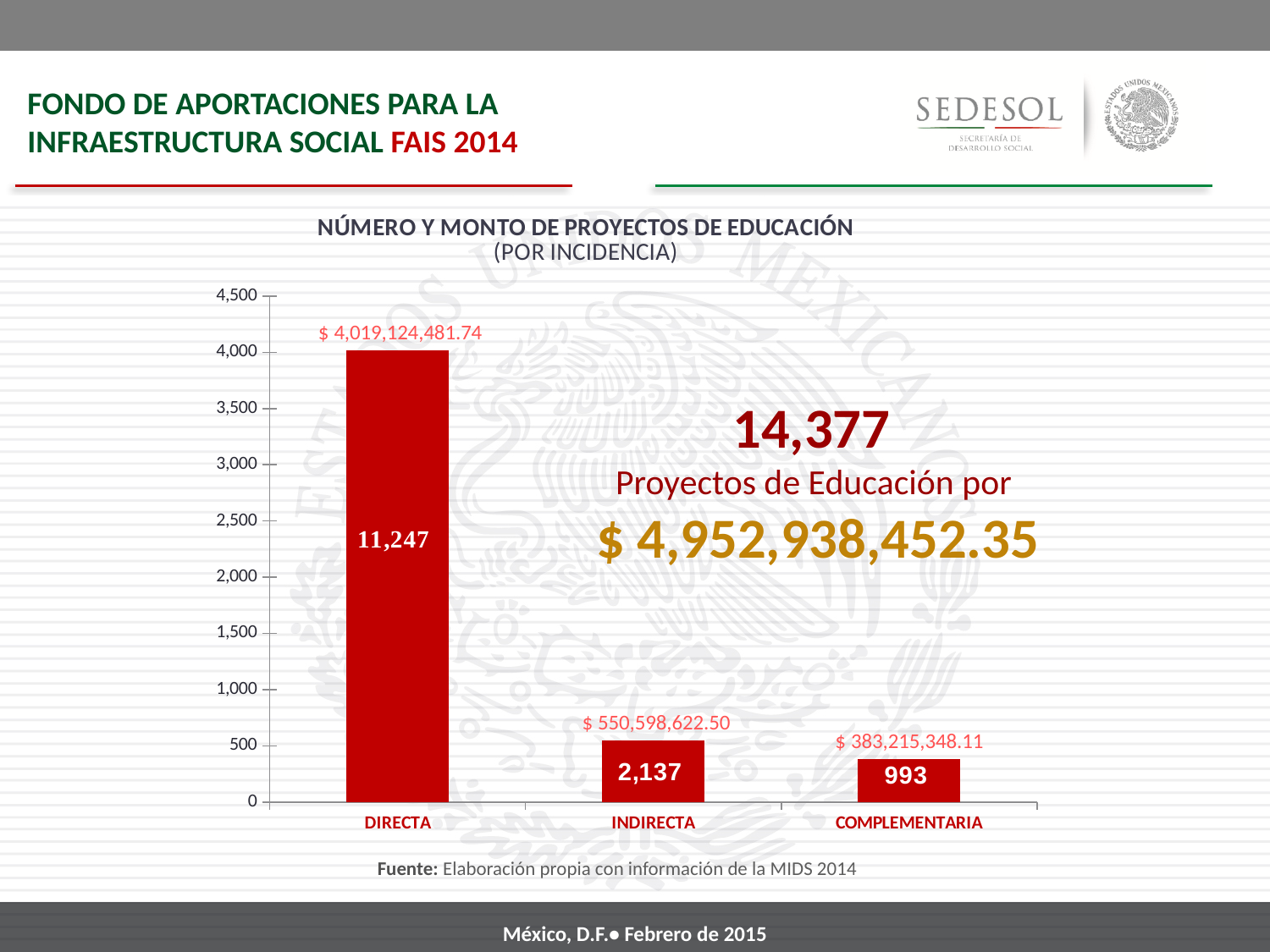
What is the title of the chart? NÚMERO Y MONTO DE PROYECTOS DE EDUCACIÓN (POR INCIDENCIA) Which category has the shortest bar? COMPLEMENTARIA What amount is printed above the DIRECTA bar? $ 4,019,124,481.74 What is the number of projects labelled on the COMPLEMENTARIA bar? 993 What is the difference between the number of projects for INDIRECTA and COMPLEMENTARIA? 1,144 What type of chart is shown on the slide? bar chart What is the number of projects labelled on the INDIRECTA bar? 2,137 Which category has the tallest bar? DIRECTA How many categories are shown on the x axis of the chart? 3 What amount is printed above the INDIRECTA bar? $ 550,598,622.50 What amount is printed above the COMPLEMENTARIA bar? $ 383,215,348.11 What is the number of projects labelled on the DIRECTA bar? 11,247